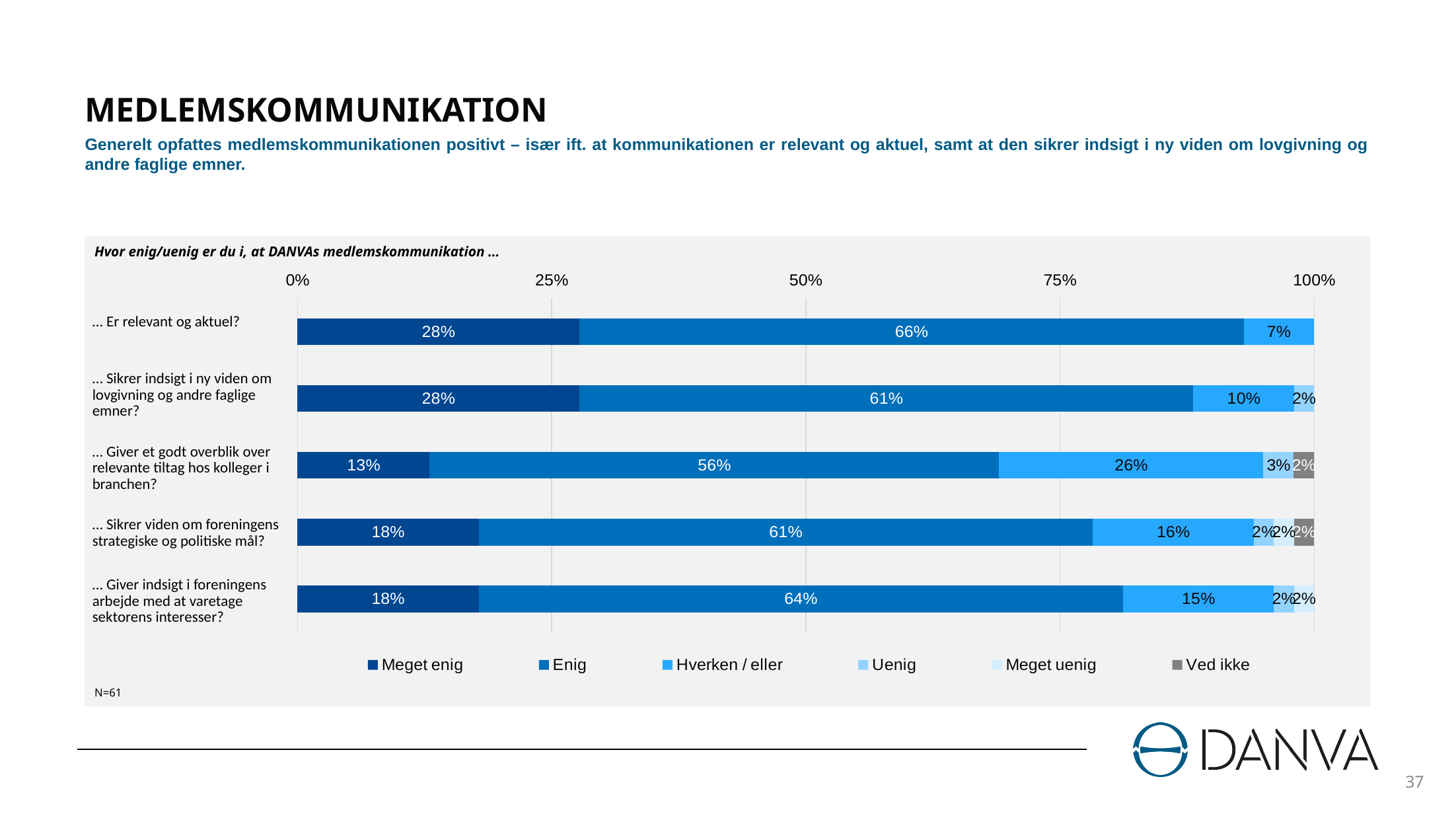
What kind of chart is shown on the slide? Stacked bar chart What is the 'Enig' share for '... Giver et godt overblik over relevante tiltag hos kolleger i branchen?'? 56% What is the difference between the 'Hverken / eller' share for '... Giver et godt overblik over relevante tiltag hos kolleger i branchen?' and for '... Er relevant og aktuel?'? 19% Which is larger: the 'Enig' share for '... Giver indsigt i foreningens arbejde med at varetage sektorens interesser?' or for '... Sikrer indsigt i ny viden om lovgivning og andre faglige emner?'? ... Giver indsigt i foreningens arbejde med at varetage sektorens interesser? What is the question text shown as the chart's title? Hvor enig/uenig er du i, at DANVAs medlemskommunikation … How many statements (categories) are plotted in the chart? 5 What is the 'Meget enig' share for '... Er relevant og aktuel?'? 28% How many series does the legend list? 6 Which statement has the highest 'Enig' share? ... Er relevant og aktuel? What is the sample size (N) stated below the chart? N=61 What is the 'Hverken / eller' share for '... Sikrer viden om foreningens strategiske og politiske mål?'? 16% Which statement has the lowest 'Meget enig' share? ... Giver et godt overblik over relevante tiltag hos kolleger i branchen?